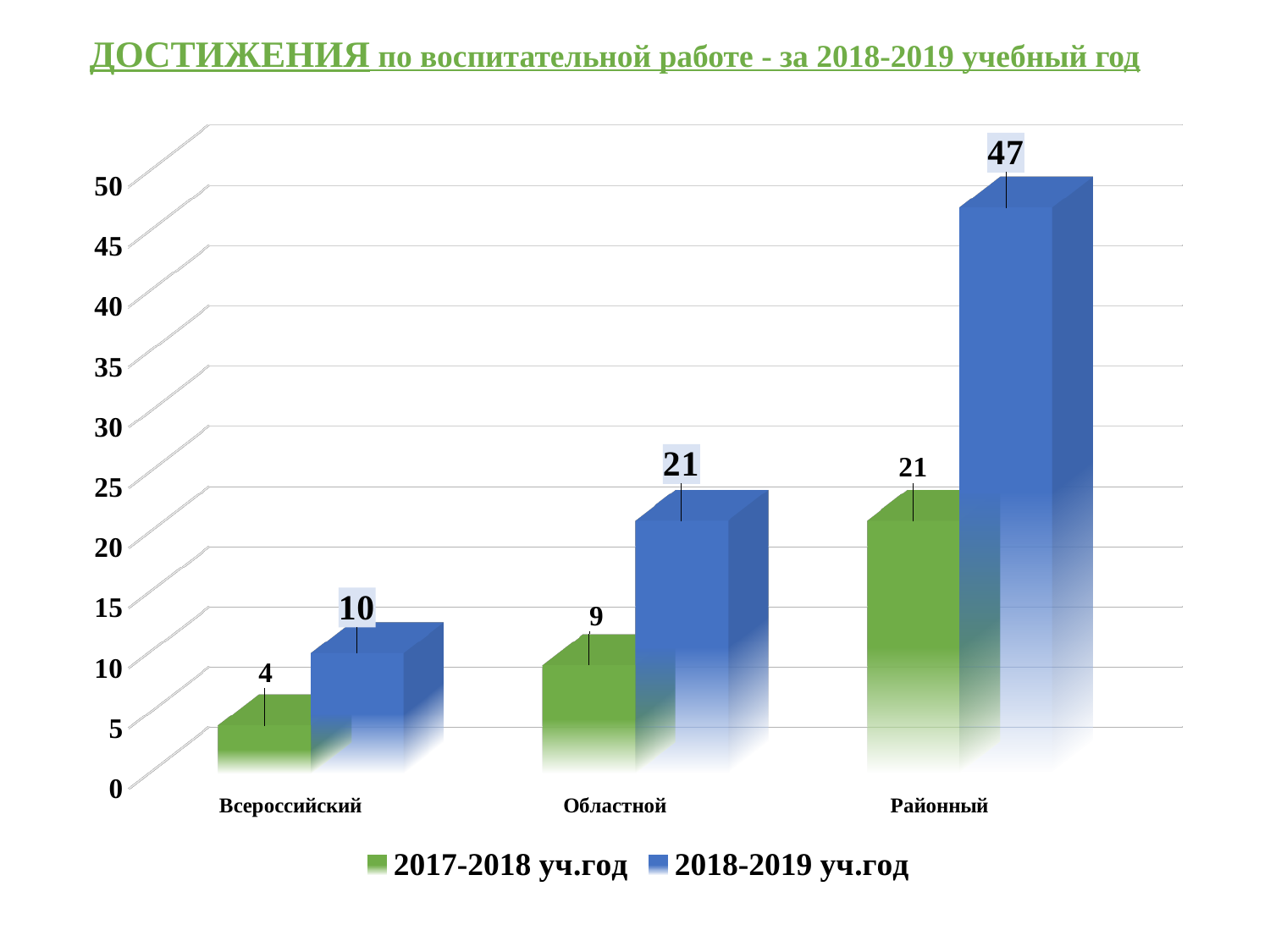
Which is larger for Областной: the 2017-2018 уч.год value or the 2018-2019 уч.год value? 2018-2019 уч.год What kind of chart is shown on the slide? bar chart What is the value for Всероссийский in the 2017-2018 уч.год series? 4 How many categories are shown on the x axis? 3 How many series does the legend list? 2 Which category has the lowest value in the 2017-2018 уч.год series? Всероссийский What is the value for Районный in the 2018-2019 уч.год series? 47 What is the value for Областной in the 2018-2019 уч.год series? 21 Is the value for Районный in the 2018-2019 уч.год series greater or less than 40? greater What is the difference between the 2018-2019 уч.год and 2017-2018 уч.год values for Районный? 26 Which category has the highest value in the 2018-2019 уч.год series? Районный Which colour represents the 2017-2018 уч.год series? green